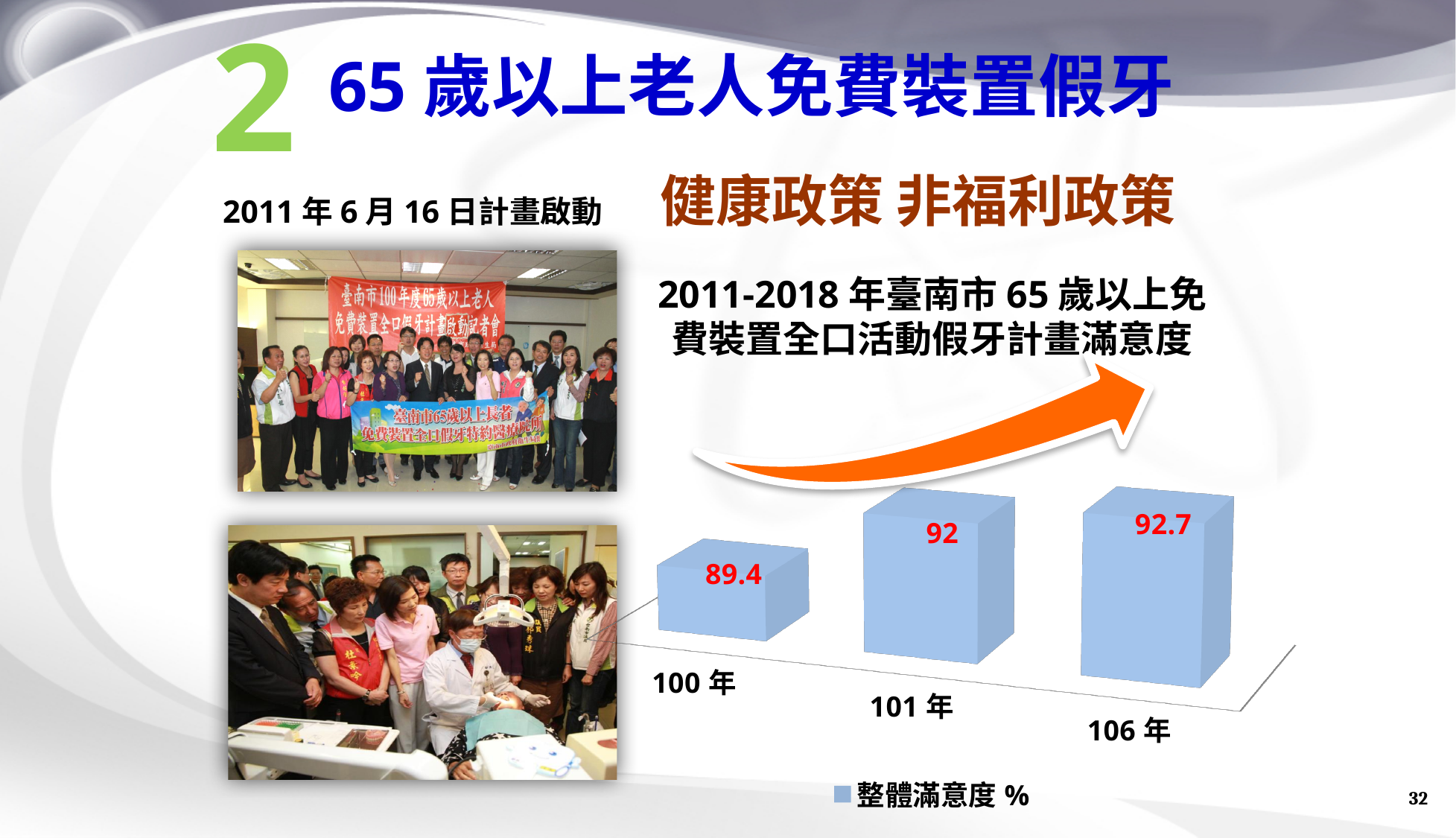
Which category has the lowest value? 100 年 How many categories are shown in the chart? 3 How many series does the legend list? 1 What is the value for 100 年? 89.4 What is the value for 101 年? 92 What is the value for 106 年? 92.7 Which is larger, the value for 101 年 or the value for 100 年? 101 年 What kind of chart is shown? Bar chart Which category has the highest value? 106 年 What is the difference between the values for 101 年 and 100 年? 2.6 What is the difference between the values for 106 年 and 100 年? 3.3 Do the values rise or fall from 100 年 to 106 年? Rise